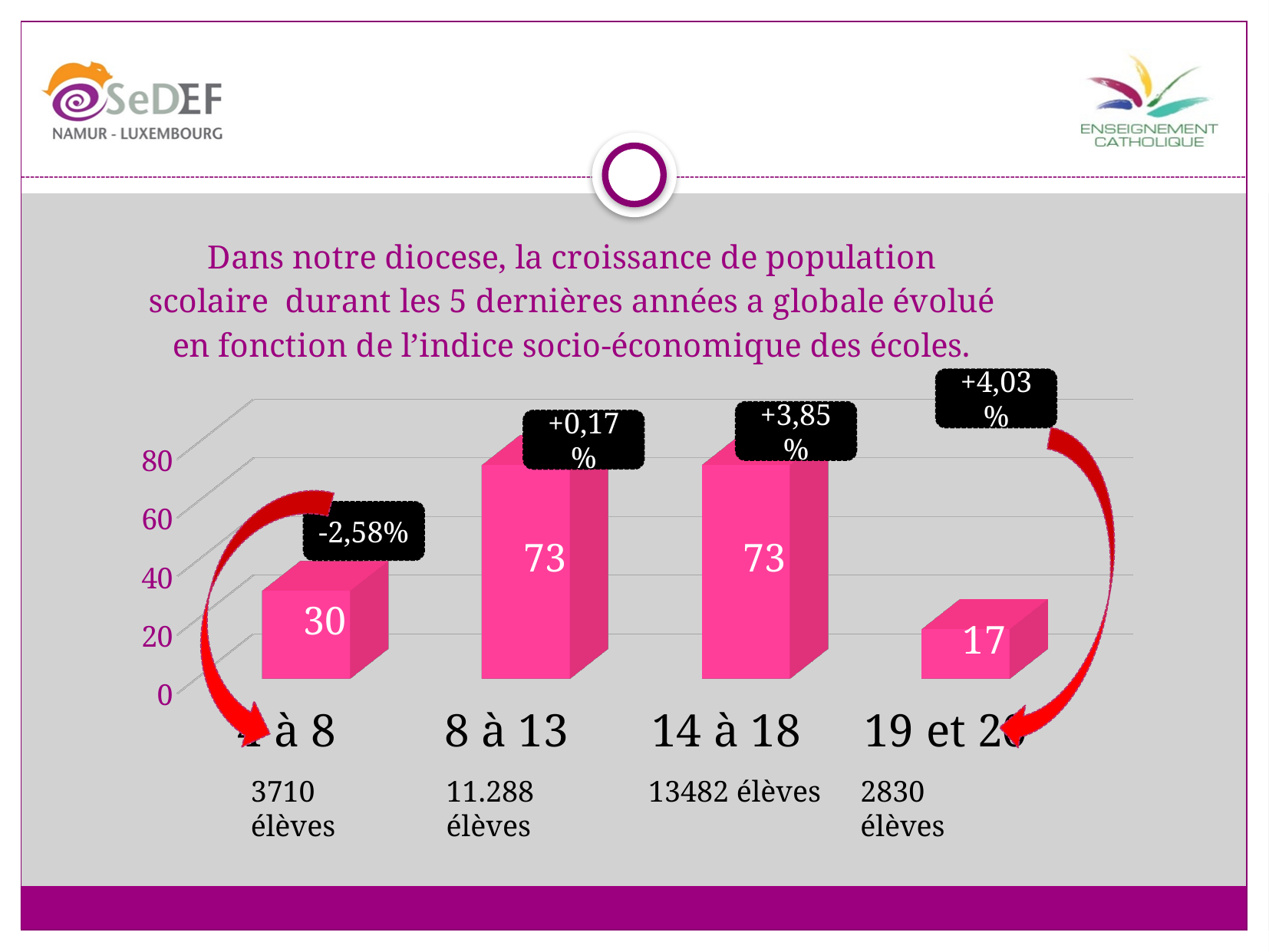
Is the value for "8 à 13" greater or less than 60? greater Which is larger: the leftmost bar ("4 à 8") or the rightmost bar ("19 et 20")? 4 à 8 How many bars are shown in the chart? 4 What is the value of the rightmost bar (category "19 et 20")? 17 What kind of chart is shown on the slide? bar chart Which category has the lowest bar? 19 et 20 What is the value of the bar for the category "14 à 18"? 73 What is the difference between the bar for "8 à 13" and the leftmost bar ("4 à 8")? 43 What percentage is shown in the black label above the "14 à 18" bar? +3,85 % What is the value of the bar for the category "8 à 13"? 73 What is the value of the leftmost bar (category "4 à 8")? 30 What is the difference between the bar for "14 à 18" and the rightmost bar ("19 et 20")? 56